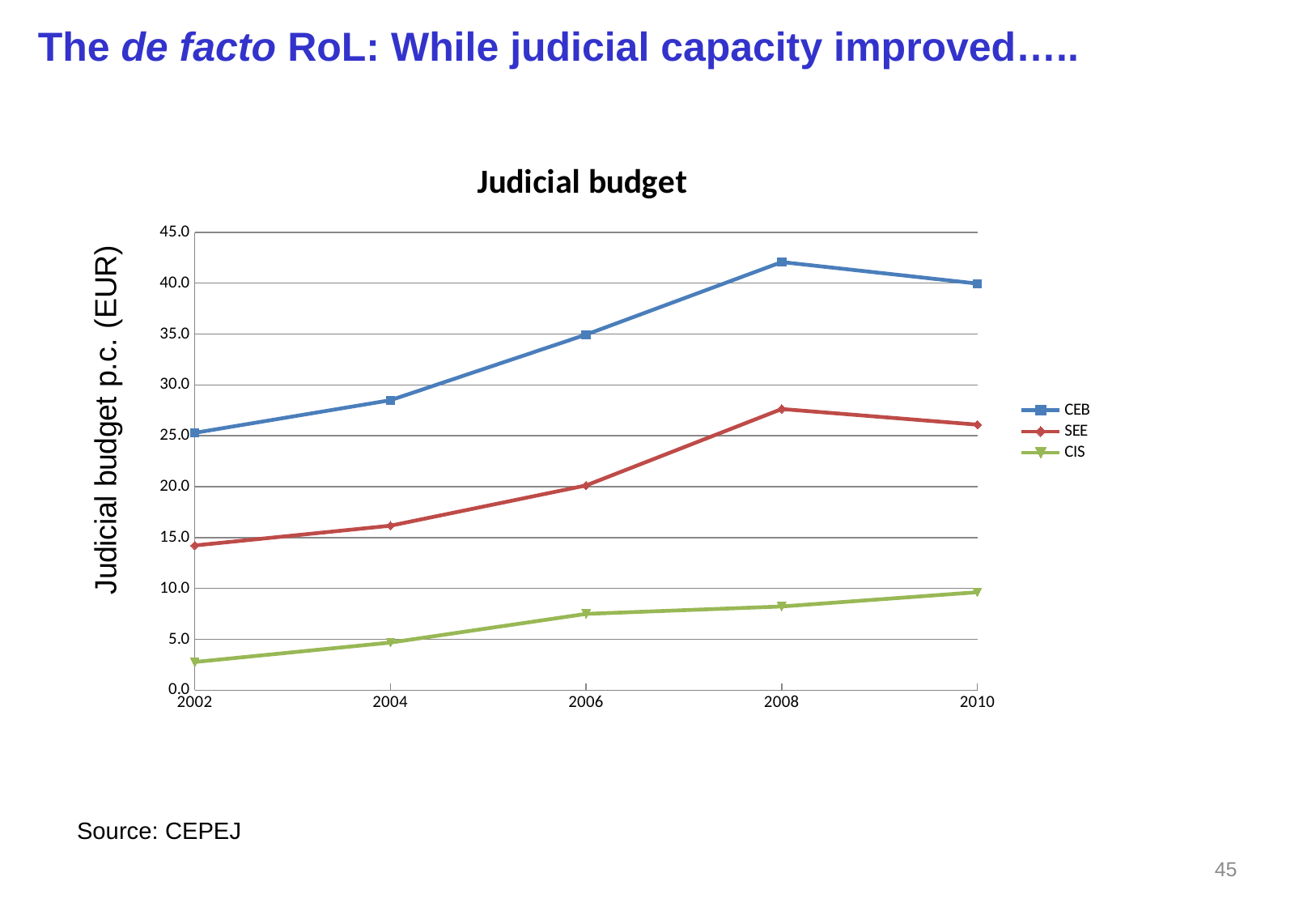
What is the title of the chart? Judicial budget How many series does the legend list? 3 Is the value for SEE in 2008 greater or less than 25.0? greater In which year does the SEE series reach its highest value? 2008 How many years are plotted along the x axis? 5 In which year is the CIS series at its lowest? 2002 In which year does the CEB series reach its highest value? 2008 Does the CIS series rise or fall from 2002 to 2010? rise Is the value for CIS in 2010 greater or less than 5.0? greater Is the value for CEB in 2002 greater or less than 30.0? less What kind of chart is shown on the slide? line chart In 2008, which series has the larger value, CEB or SEE? CEB